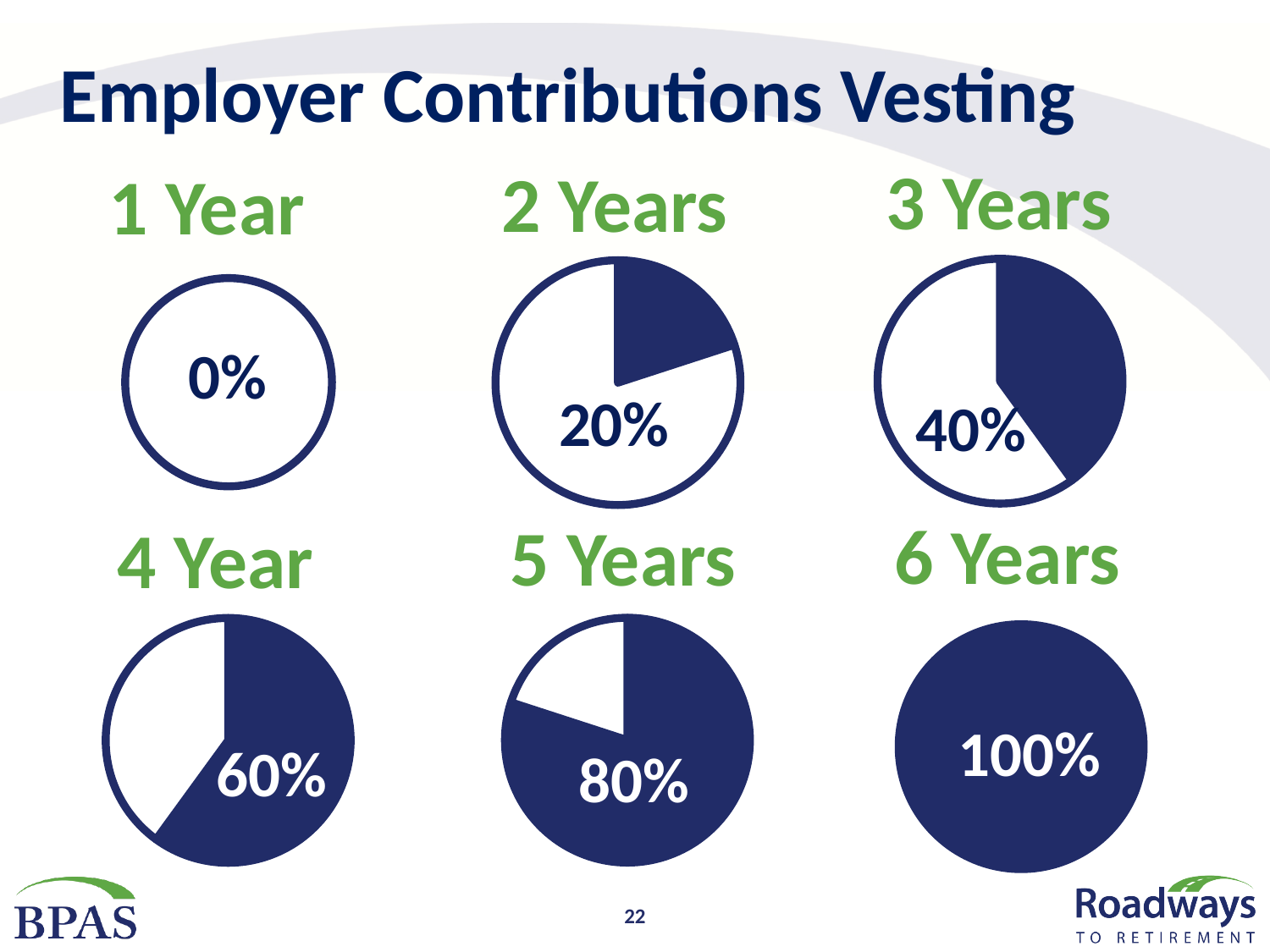
Which is larger, the vesting percentage at 3 Years or at 4 Year? 4 Year What vesting percentage is shown for 1 Year? 0% What is the difference between the vesting percentage at 5 Years and at 3 Years? 40% What is the title of the slide? Employer Contributions Vesting How many pie charts are shown on the slide? 6 Do the vesting percentages rise or fall as the number of years increases? Rise What vesting percentage is shown for 6 Years? 100% Which year has the highest vesting percentage? 6 Years What vesting percentage is shown for 4 Year? 60% What vesting percentage is shown for 2 Years? 20% Which year has the lowest vesting percentage? 1 Year What kind of chart is used to show the vesting percentages? Pie chart